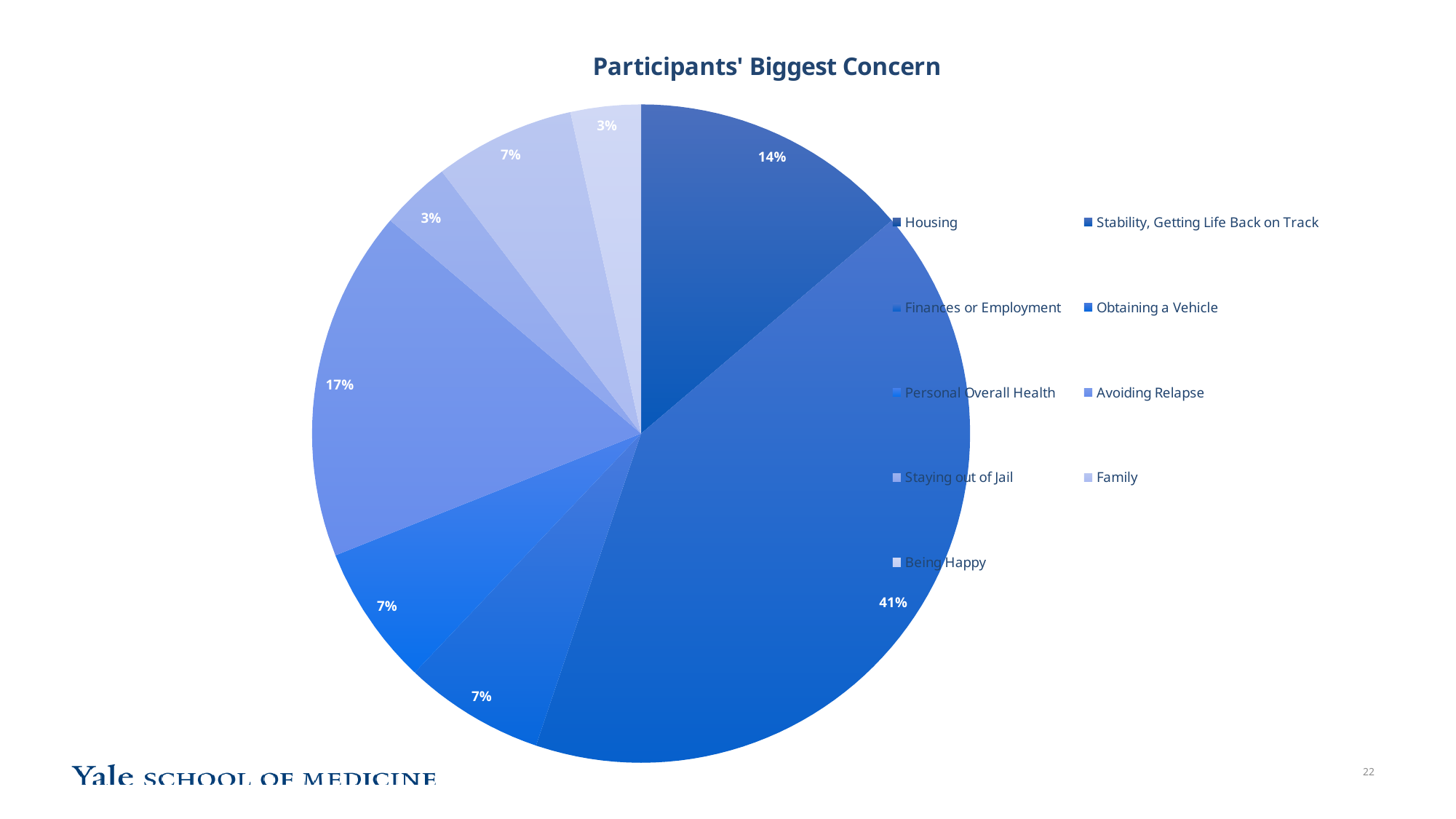
What type of chart is shown on the slide? pie chart How many categories does the legend list? 9 What share of the pie does the largest slice represent? 41% How many slices are labelled 3%? 2 What is the difference in percentage points between the 14% slice and the 7% slices? 7 What is the largest percentage shown on any slice of the pie? 41% What is the smallest percentage shown on any slice of the pie? 3% Which is larger, the 17% slice or the 14% slice? the 17% slice What is the difference in percentage points between the largest slice (41%) and the 17% slice? 24 How many slices are labelled 7%? 3 What is the title of the chart? Participants' Biggest Concern